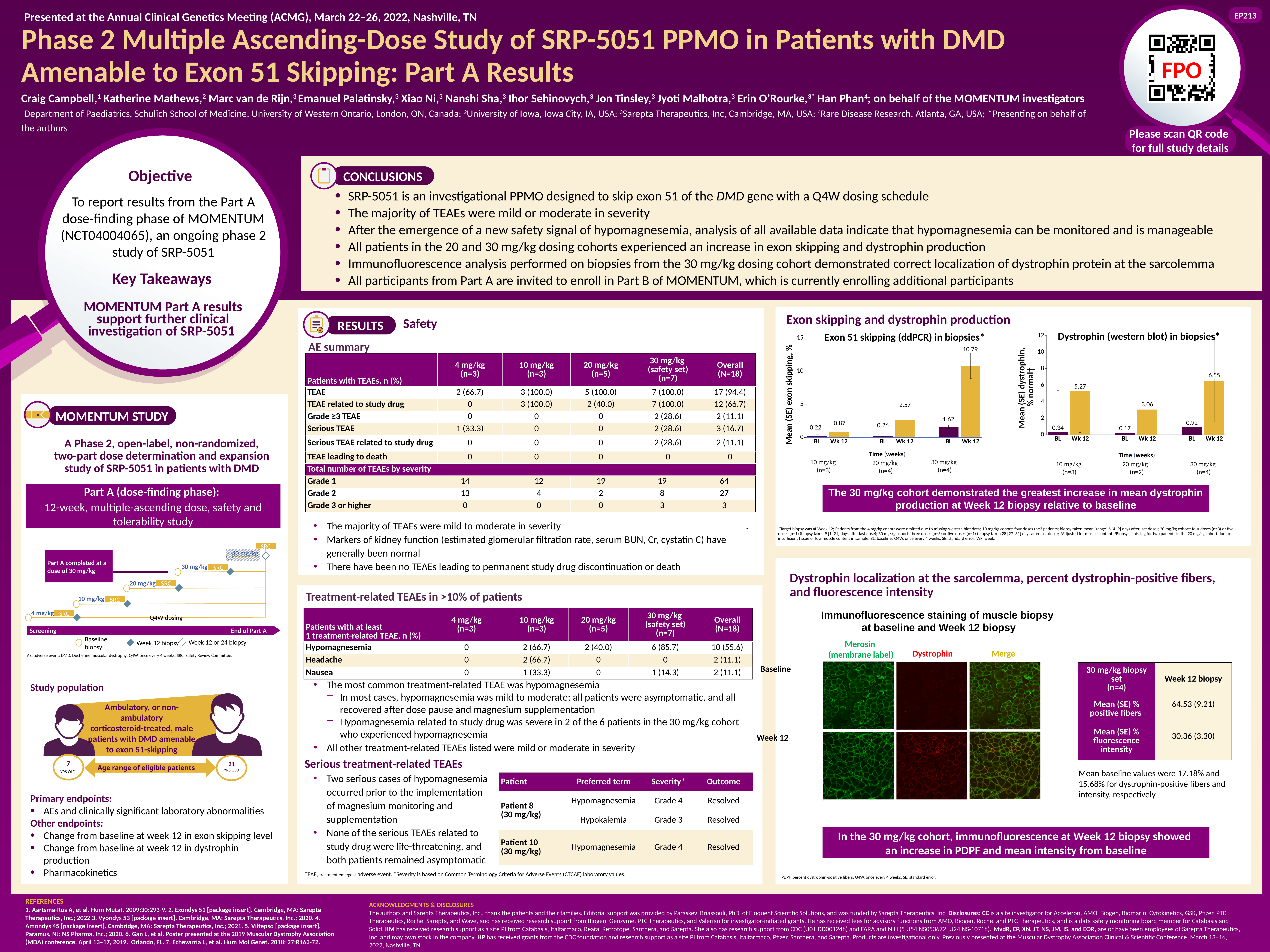
In the 'Exon 51 skipping (ddPCR) in biopsies' chart, what is the difference between the Week 12 and baseline values for the 30 mg/kg cohort? 9.17 In the 'Dystrophin (western blot) in biopsies' chart, which bar has the lowest value? 20 mg/kg BL In the 'Exon 51 skipping (ddPCR) in biopsies' chart, what is the Week 12 value for the 30 mg/kg cohort? 10.79 In the 'Dystrophin (western blot) in biopsies' chart, what is the difference between the Week 12 values for the 30 mg/kg and 20 mg/kg cohorts? 3.49 In the 'Exon 51 skipping (ddPCR) in biopsies' chart, which bar has the highest value? 30 mg/kg Wk 12 In the 'Exon 51 skipping (ddPCR) in biopsies' chart, is the Week 12 value for the 30 mg/kg cohort greater or less than 10? greater In the 'Dystrophin (western blot) in biopsies' chart, what is the Week 12 value for the 10 mg/kg cohort? 5.27 In the 'Exon 51 skipping (ddPCR) in biopsies' chart, what is the baseline (BL) value for the 20 mg/kg cohort? 0.26 What type of chart is the 'Dystrophin (western blot) in biopsies' chart? Bar chart How many bars are plotted in the 'Exon 51 skipping (ddPCR) in biopsies' chart? 6 In the 'Dystrophin (western blot) in biopsies' chart, which is larger: the Week 12 value for 10 mg/kg or the Week 12 value for 20 mg/kg? 10 mg/kg Week 12 In the 'Dystrophin (western blot) in biopsies' chart, what is the baseline (BL) value for the 30 mg/kg cohort? 0.92